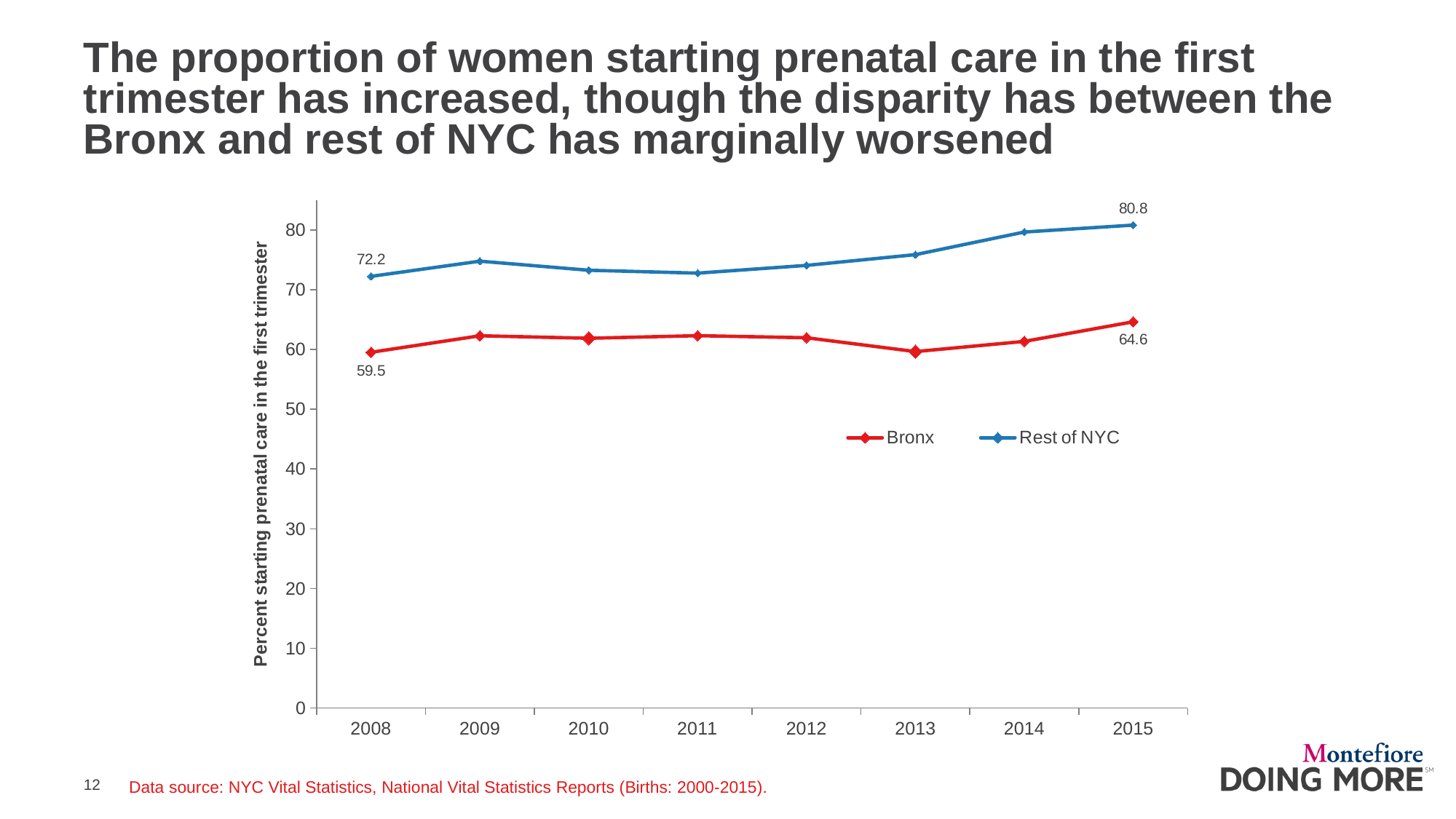
What is the value for Rest of NYC in 2015? 80.8 What kind of chart is shown on the slide? Line chart What is the value for the Bronx in 2008? 59.5 Is the value for Rest of NYC in 2014 greater or less than 70? greater How many years are shown on the x axis? 8 What is the value for the Bronx in 2015? 64.6 Which series has the higher value in 2012, Bronx or Rest of NYC? Rest of NYC What is the value for Rest of NYC in 2008? 72.2 How many series does the legend list? 2 What is the difference between the Rest of NYC and Bronx values in 2015? 16.2 What is the difference between the Rest of NYC and Bronx values in 2008? 12.7